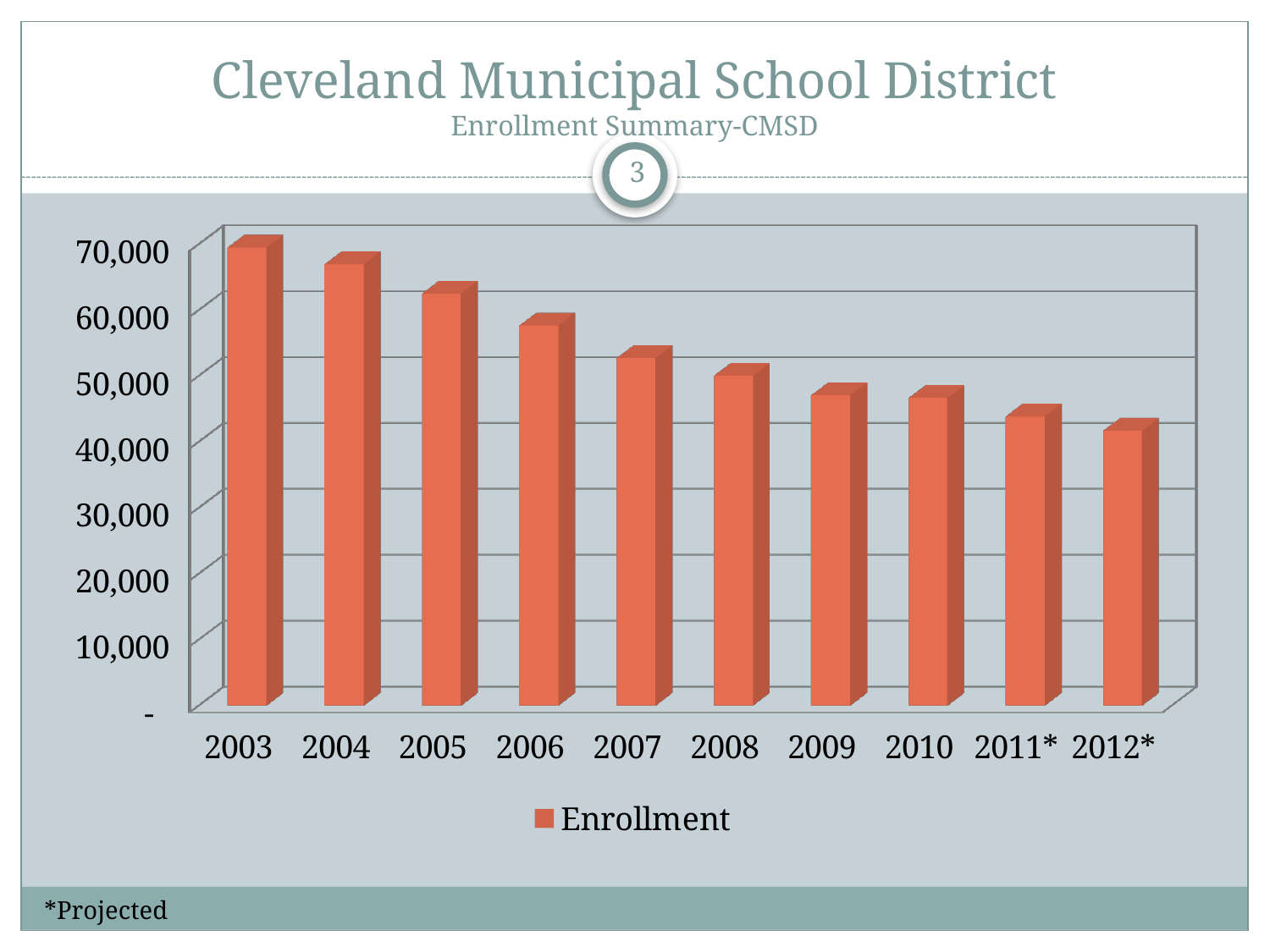
How many years are shown on the x axis? 10 Do enrollment values rise or fall from 2003 to 2012*? fall Is the enrollment for 2012* greater or less than 40,000? greater Is the enrollment for 2007 greater or less than 50,000? greater Is the enrollment for 2009 greater or less than 50,000? less How many series does the legend list? 1 What kind of chart is shown on the slide? bar chart Which year has the highest enrollment? 2003 Which year has the larger enrollment, 2004 or 2010? 2004 What is the name of the series shown in the legend? Enrollment Which year has the lowest enrollment? 2012*